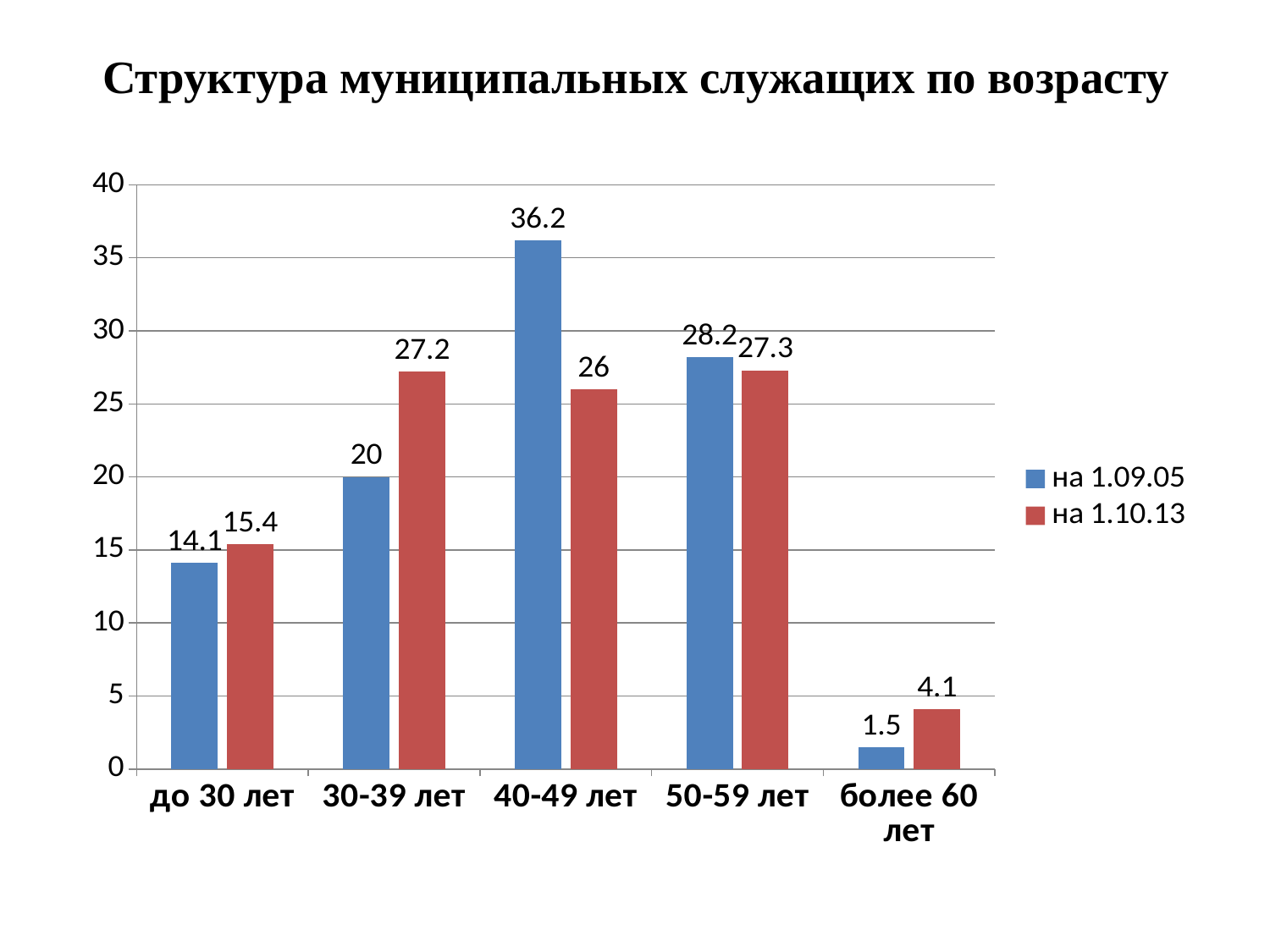
Which is larger for 30-39 лет: the value for на 1.09.05 or на 1.10.13? на 1.10.13 What is the value for более 60 лет in the series на 1.09.05? 1.5 What is the value for 30-39 лет in the series на 1.10.13? 27.2 Which age category has the highest value in the series на 1.09.05? 40-49 лет Is the value for 50-59 лет in the series на 1.10.13 greater or less than 25? greater How many age categories are shown on the x axis? 5 What is the title of the chart? Структура муниципальных служащих по возрасту What kind of chart is shown on the slide? bar chart How many series does the legend list? 2 What is the difference between the на 1.09.05 and на 1.10.13 values for 40-49 лет? 10.2 Which age category has the lowest value in the series на 1.10.13? более 60 лет What is the value for 40-49 лет in the series на 1.09.05? 36.2